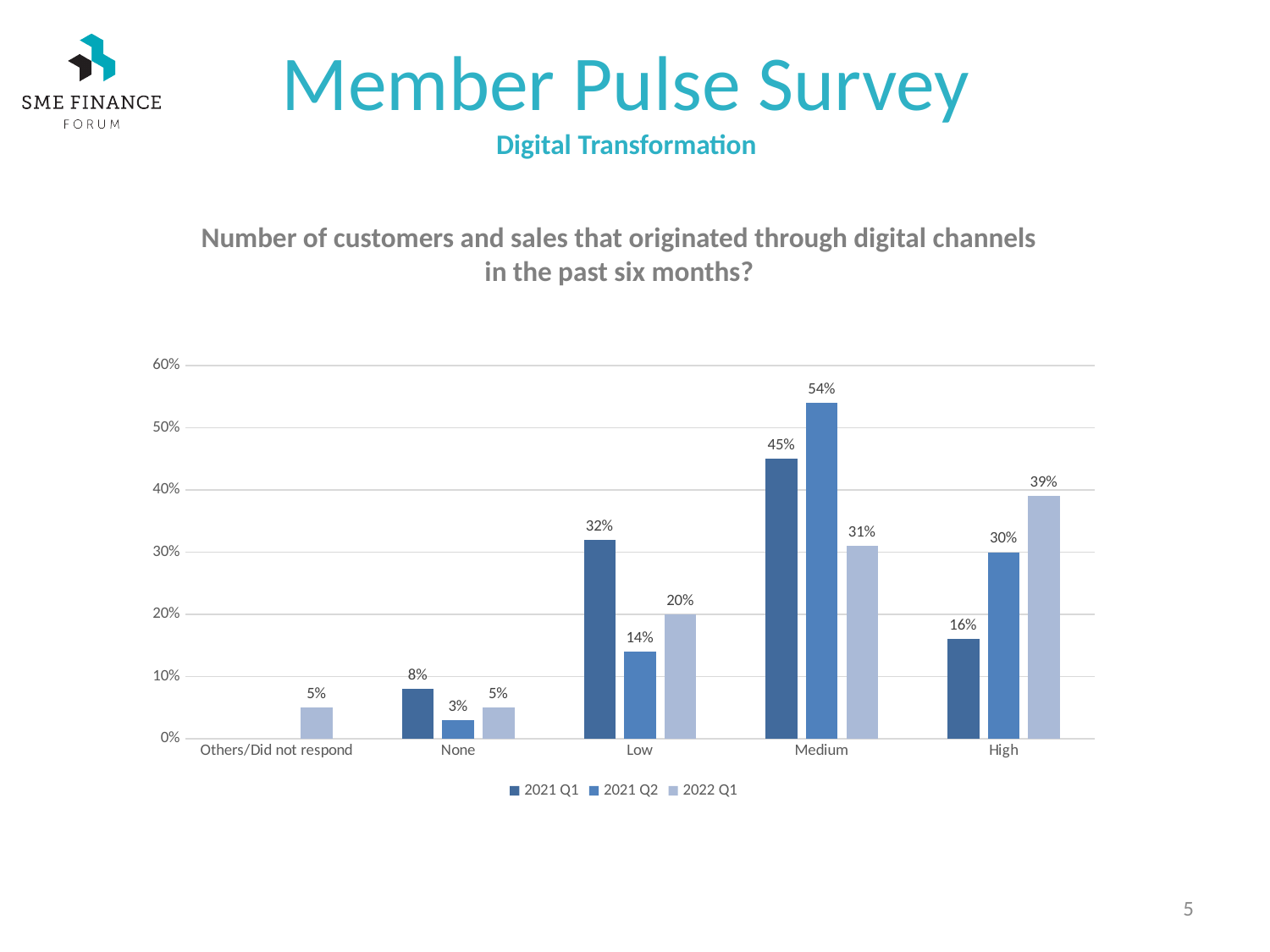
What is the value for High in the 2022 Q1 series? 39% How many series does the legend list? 3 What is the value for Low in the 2021 Q1 series? 32% What kind of chart is shown on the slide? Bar chart Is the value for Low in the 2021 Q2 series greater or less than 20%? less Do the 2022 Q1 values rise or fall from None to High? Rise What is the difference between the 2021 Q2 and 2022 Q1 values for Medium? 23% Which category has the highest value in the 2021 Q2 series? Medium What is the value for Medium in the 2021 Q2 series? 54% How many categories are shown on the x axis? 5 Which is larger for High: the 2021 Q1 value or the 2022 Q1 value? 2022 Q1